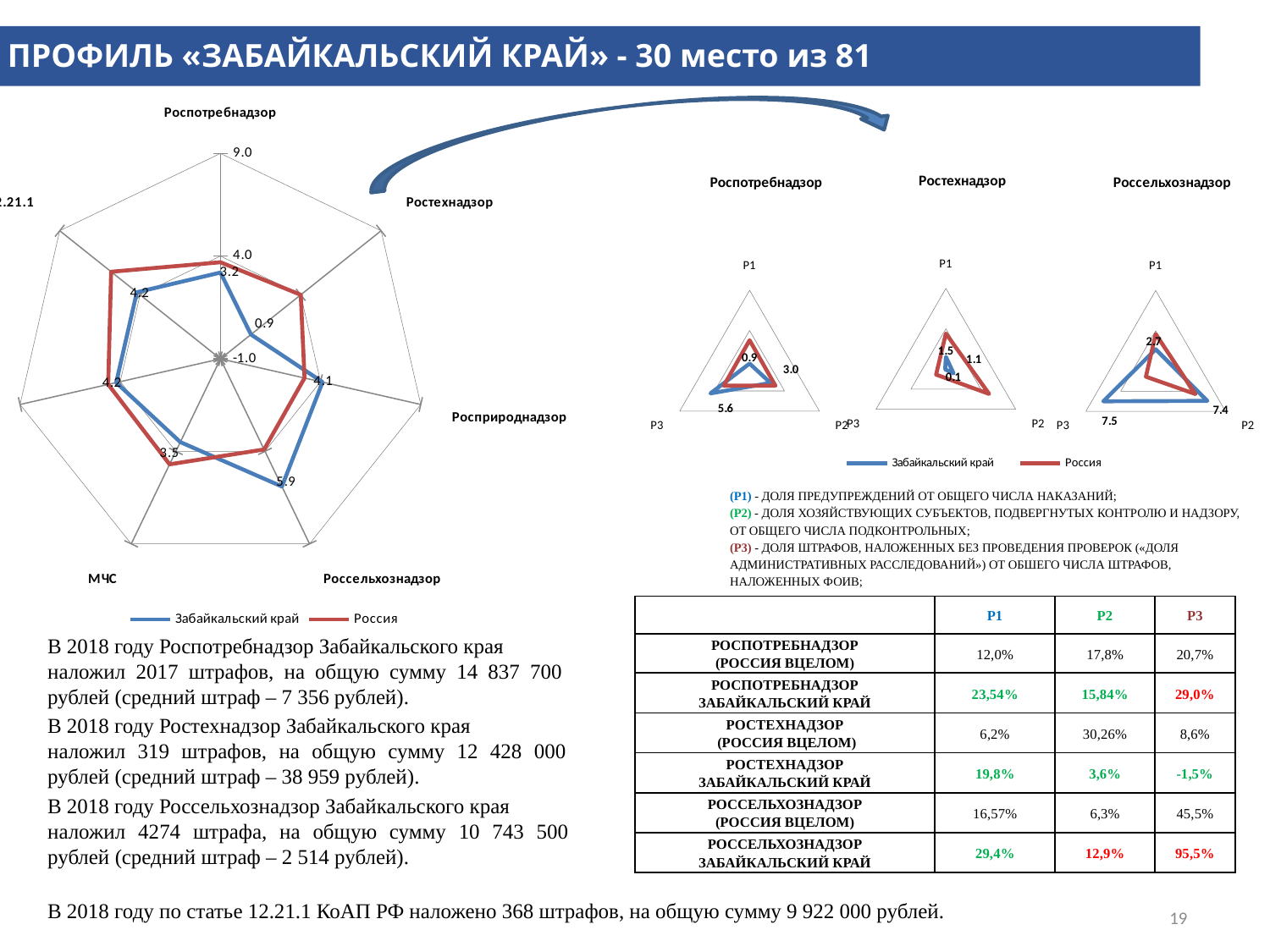
On the large left radar chart, what value is printed for Забайкальский край on the Россельхознадзор axis? 5.9 How many series does the legend of the large left radar chart list? 2 How many axes (categories) does the large left radar chart have? 7 On the large left radar chart, which of the labelled Забайкальский край values is the highest? Россельхознадзор (5.9) On the small Россельхознадзор radar chart on the right, what value is printed at P2? 7.4 On the large left radar chart, which is larger for Забайкальский край: the Росприроднадзор value or the Ростехнадзор value? Росприроднадзор On the large left radar chart, what is the difference between the Забайкальский край values on the Россельхознадзор axis and the МЧС axis? 2.4 On the small Ростехнадзор radar chart on the right, what value is printed at P3? 0.1 On the large left radar chart, what value is printed for Забайкальский край on the Росприроднадзор axis? 4.1 On the large left radar chart, what value is printed for Забайкальский край on the МЧС axis? 3.5 On the small Роспотребнадзор radar chart on the right, what value is printed at P3? 5.6 What kind of chart is the large chart on the left of the slide? radar chart